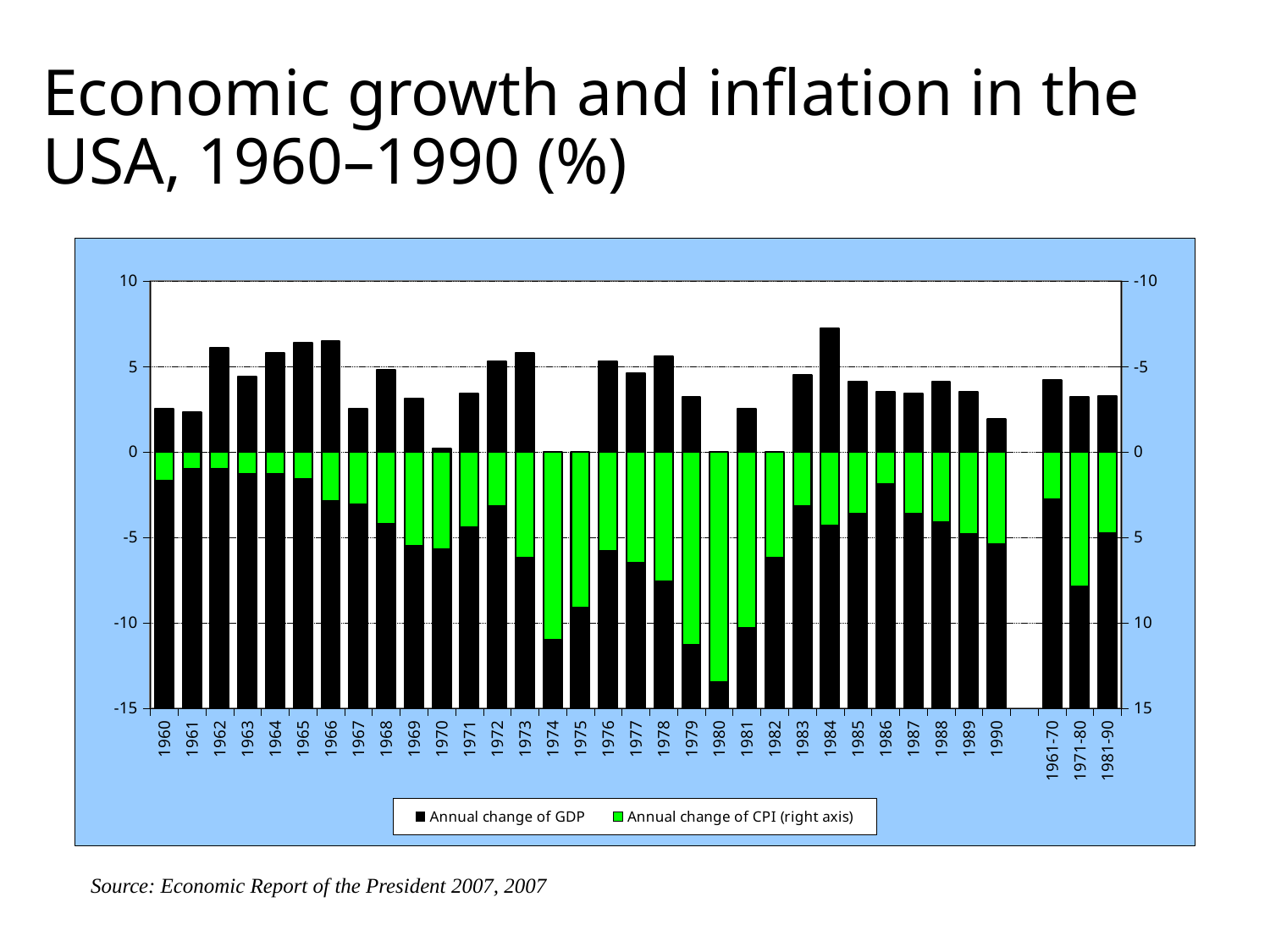
Is the annual change of GDP for 1984 greater or less than 5? greater How many series does the legend list? 2 What kind of chart is shown on the slide? Bar chart Does the annual change of CPI rise or fall from 1976 to 1980? rise How many categories are shown on the x axis, including the decade averages? 34 Which series does the legend say is plotted on the right axis? Annual change of CPI Is the annual change of CPI for 1961-70 greater or less than 5? less Which year has the highest annual change of GDP? 1984 Which has the larger annual change of CPI, 1979 or 1983? 1979 Is the annual change of CPI for 1974 greater or less than 10? greater Which year has the highest annual change of CPI? 1980 What is the title of the slide's chart? Economic growth and inflation in the USA, 1960–1990 (%)